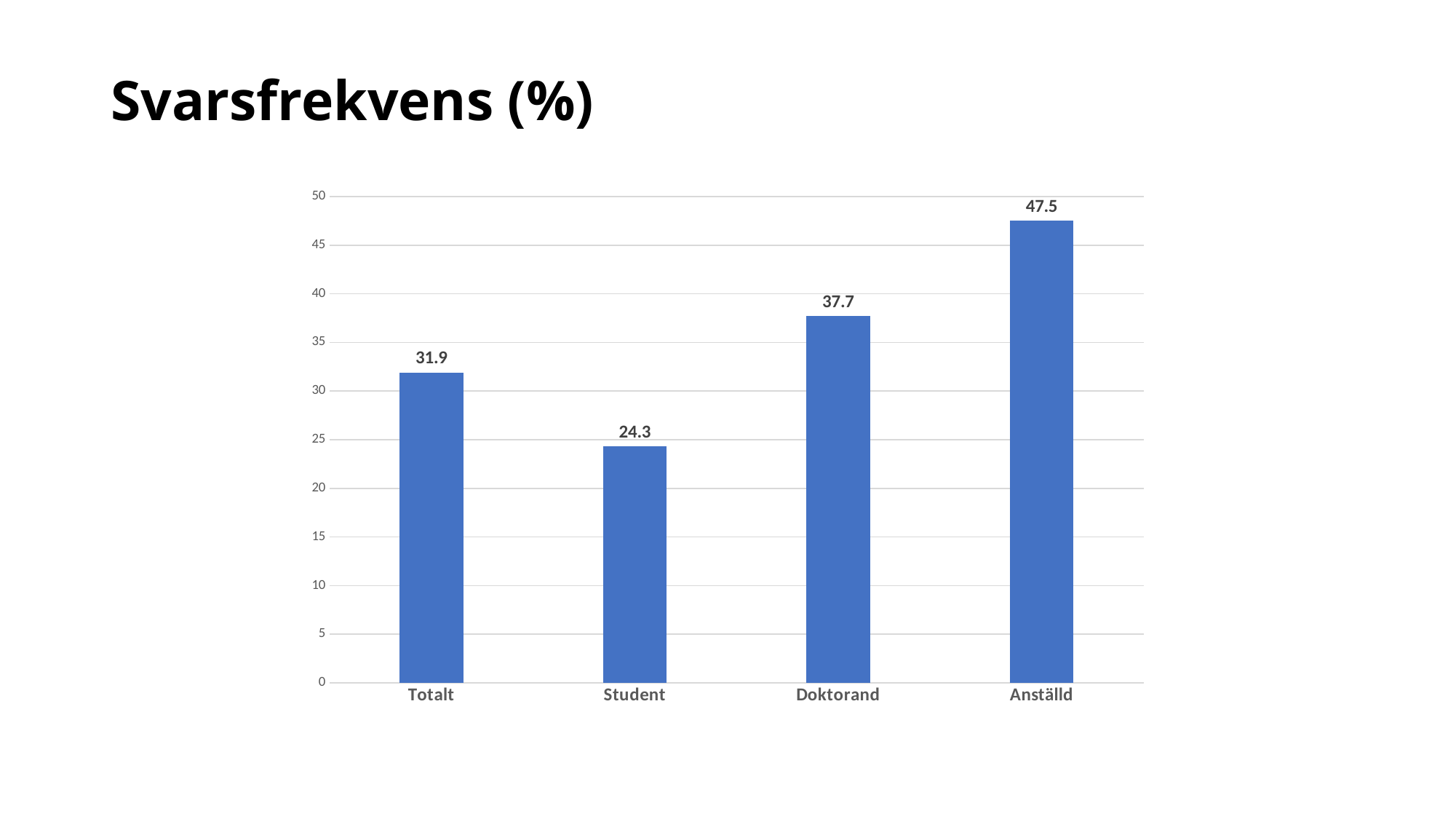
What is the value for Student? 24.3 How many categories are shown on the x axis? 4 Which is larger, the value for Doktorand or the value for Totalt? Doktorand What is the value for Doktorand? 37.7 What is the value for Totalt? 31.9 What kind of chart is shown on the slide? bar chart Is the value for Student greater or less than 25? less Which category has the lowest value? Student What is the difference between the values for Doktorand and Totalt? 5.8 Which category has the highest value? Anställd What is the difference between the values for Anställd and Student? 23.2 What is the value for Anställd? 47.5